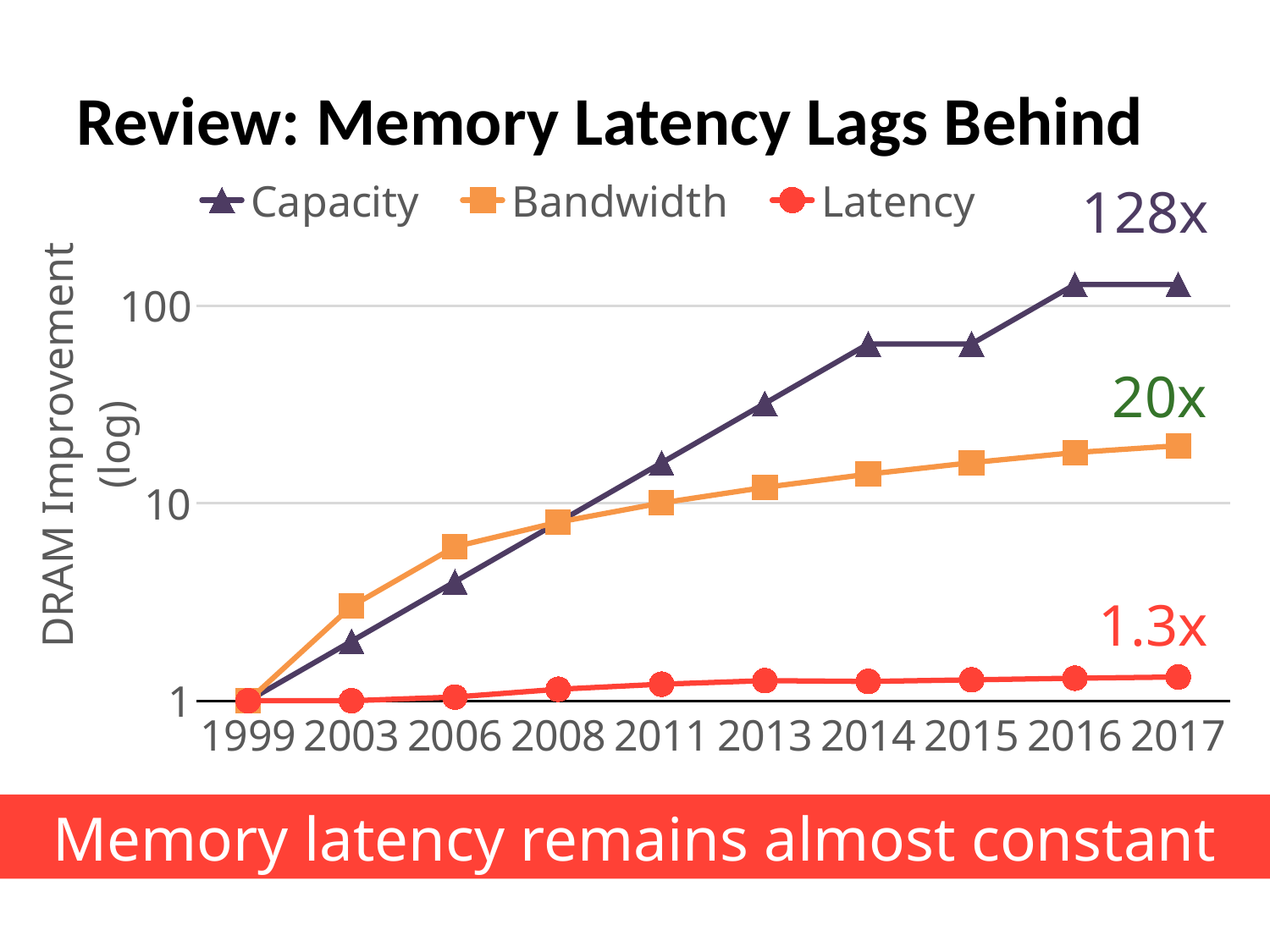
What is the Capacity improvement value labelled at 2017? 128x What is the title of the y axis? DRAM Improvement (log) What is the Latency improvement value labelled at 2017? 1.3x Which series has the highest value in 2017? Capacity In 2006, which is larger: Bandwidth or Capacity? Bandwidth Is the Capacity value for 2014 greater or less than 100? less What is the Bandwidth improvement value labelled at 2017? 20x Which series has the lowest value in 2017? Latency How many series does the legend list? 3 What kind of chart is shown on the slide? line chart How many years are plotted along the x axis? 10 Does the Capacity series rise or fall from 1999 to 2017? rise